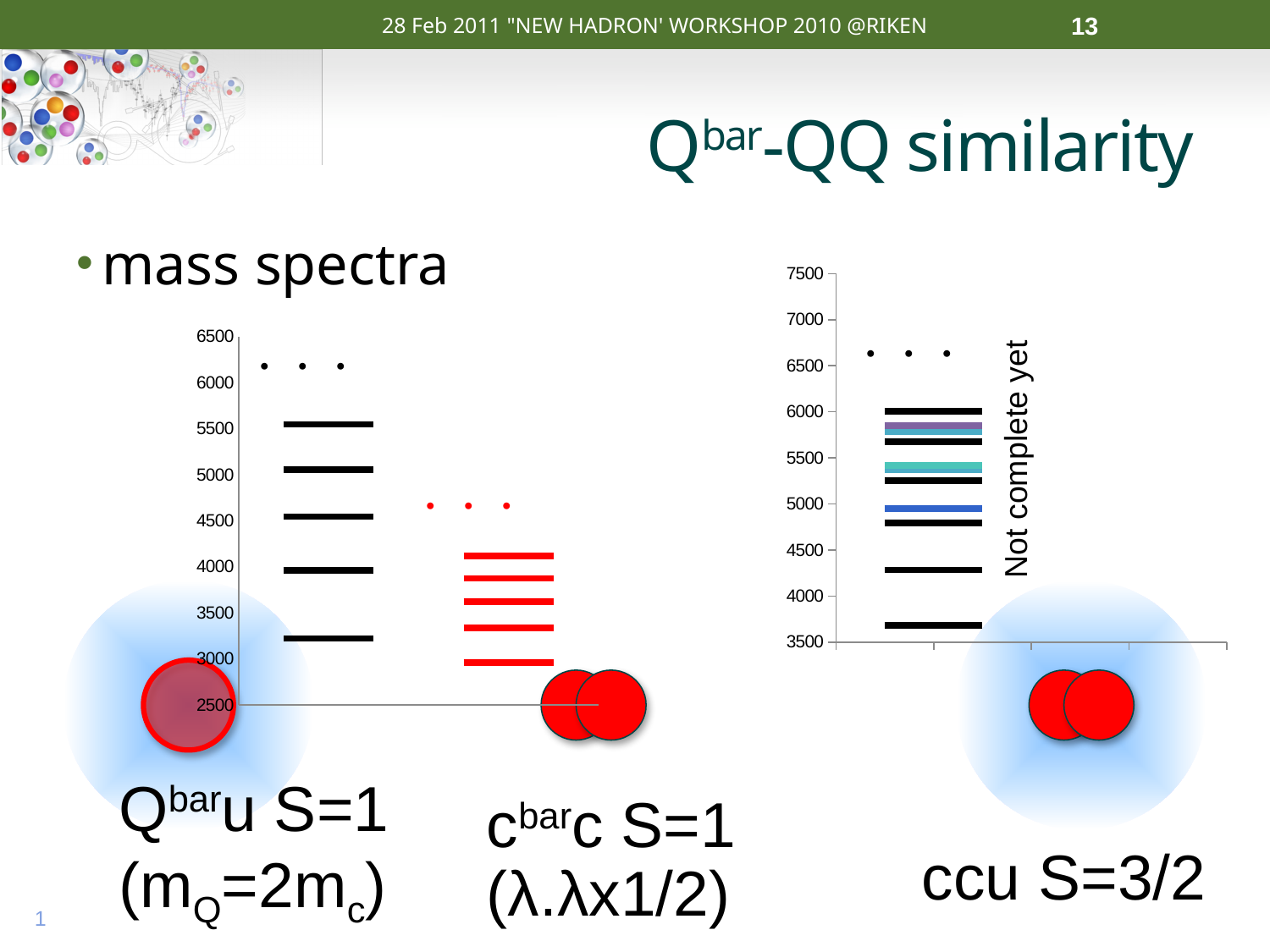
On the right chart (ccu S=3/2), is the highest level line greater or less than 5500? greater On the left chart, how many black horizontal level lines are plotted for Q̄u S=1? 5 On the left chart, is the highest red level line greater or less than 4500? less On the right chart (ccu S=3/2), is the lowest level line greater or less than 4000? less On the left chart, which is higher: the highest black level line or the highest red level line? the highest black level line What is the highest value shown on the y axis of the left chart? 6500 What is the lowest value shown on the y axis of the right chart? 3500 On the left chart, how many red horizontal level lines are plotted for c̄c S=1? 5